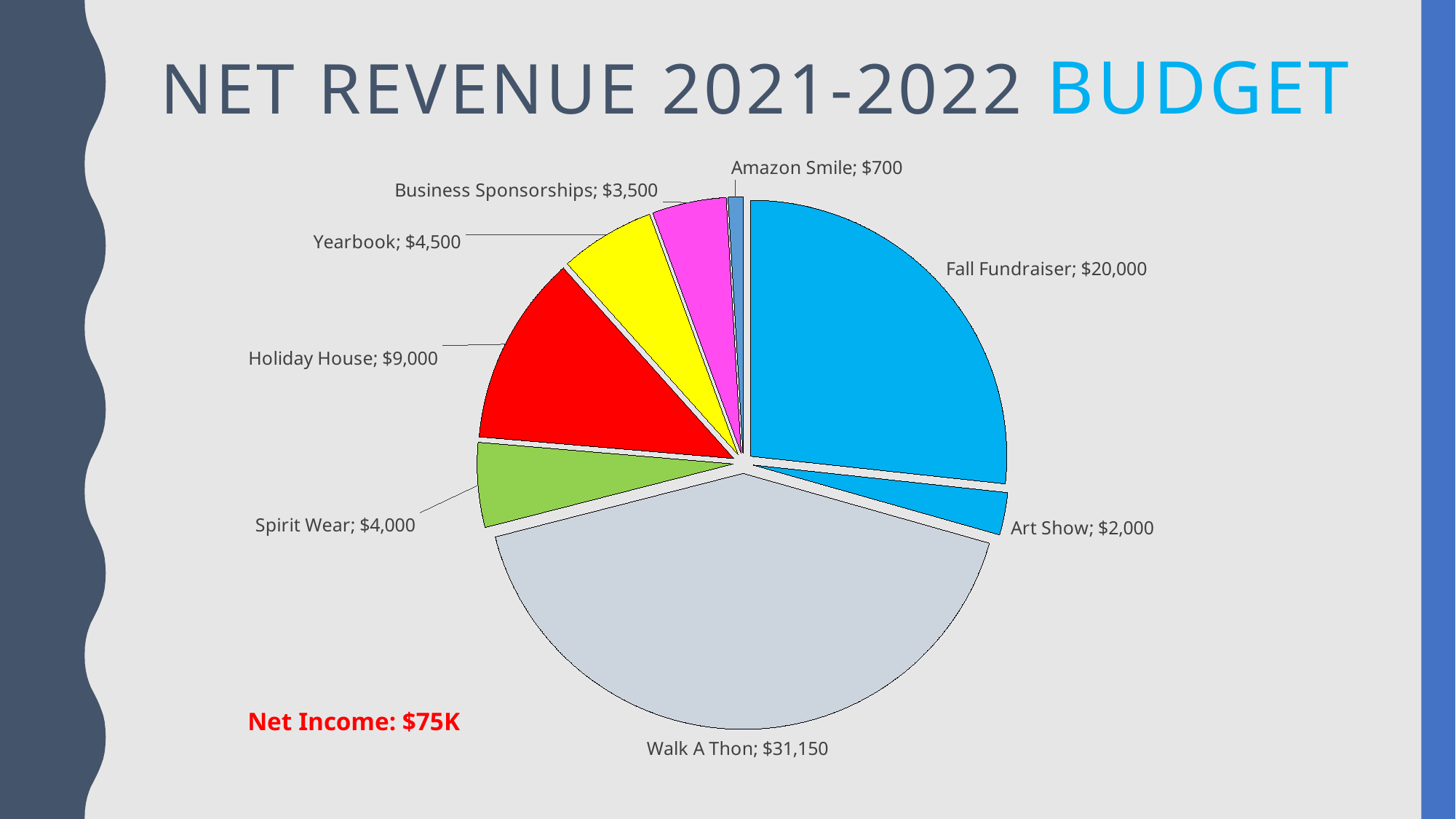
What is the value for Fall Fundraiser? $20,000 What is the value for Amazon Smile? $700 What is the value for Holiday House? $9,000 What is the difference between the Holiday House value and the Spirit Wear value? $5,000 Which is larger, Yearbook or Business Sponsorships? Yearbook What is the title of the slide containing the chart? NET REVENUE 2021-2022 BUDGET What is the difference between the Walk A Thon value and the Fall Fundraiser value? $11,150 What type of chart is shown on the slide? Pie chart What is the value for Walk A Thon? $31,150 Which category has the largest slice of the pie? Walk A Thon How many categories are shown in the pie chart? 8 Which category has the smallest slice of the pie? Amazon Smile